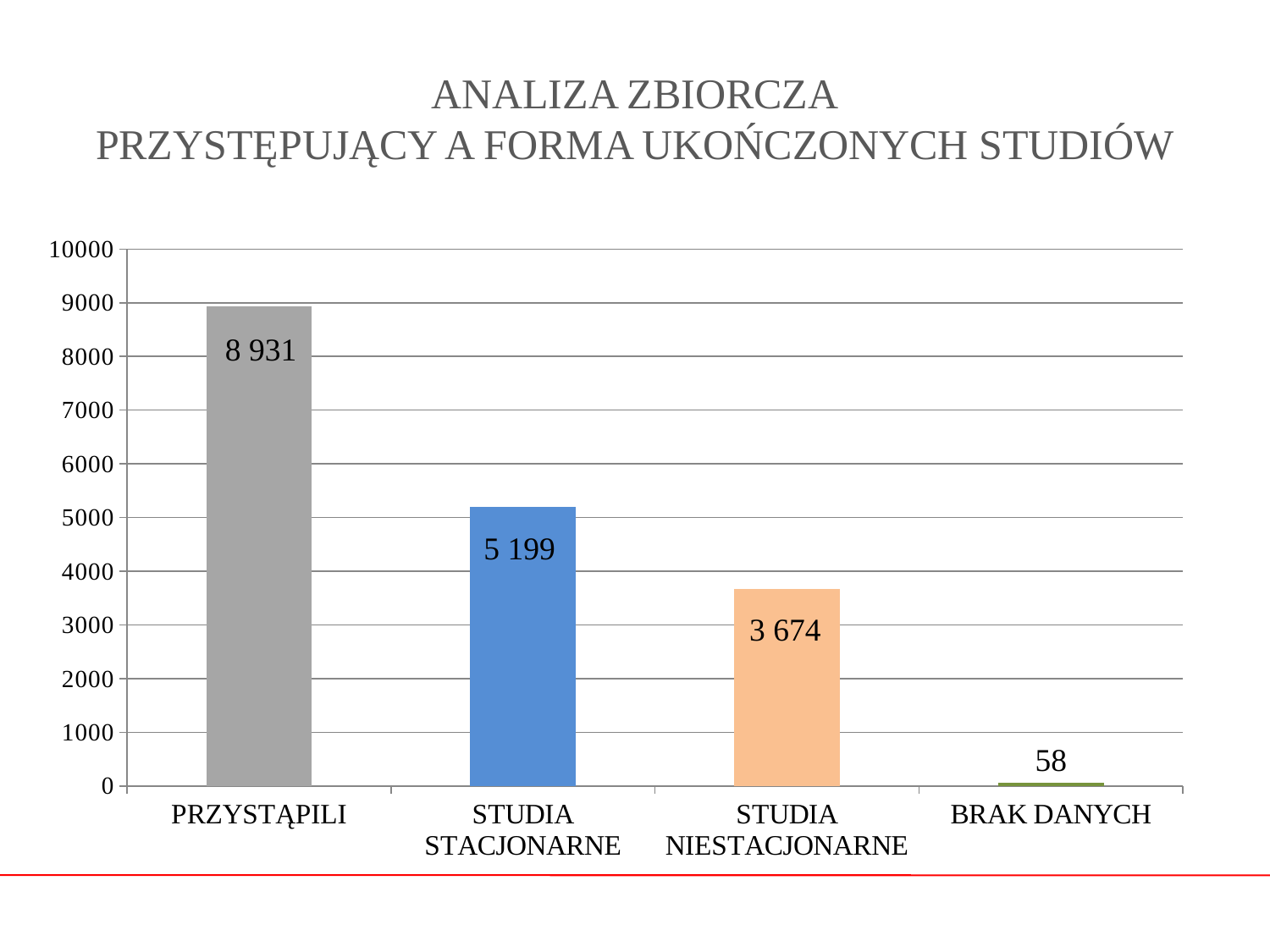
What is the value for STUDIA NIESTACJONARNE? 3 674 What is the value for BRAK DANYCH? 58 How many categories are shown on the x axis? 4 What kind of chart is shown on the slide? bar chart Which category has the highest value? PRZYSTĄPILI Which category has the lowest value? BRAK DANYCH What is the difference between the values for STUDIA STACJONARNE and STUDIA NIESTACJONARNE? 1 525 Is the value for STUDIA NIESTACJONARNE greater or less than 4000? less What is the title of the slide? ANALIZA ZBIORCZA PRZYSTĘPUJĄCY A FORMA UKOŃCZONYCH STUDIÓW Which is larger, the value for STUDIA STACJONARNE or the value for STUDIA NIESTACJONARNE? STUDIA STACJONARNE What is the value for PRZYSTĄPILI? 8 931 What is the value for STUDIA STACJONARNE? 5 199